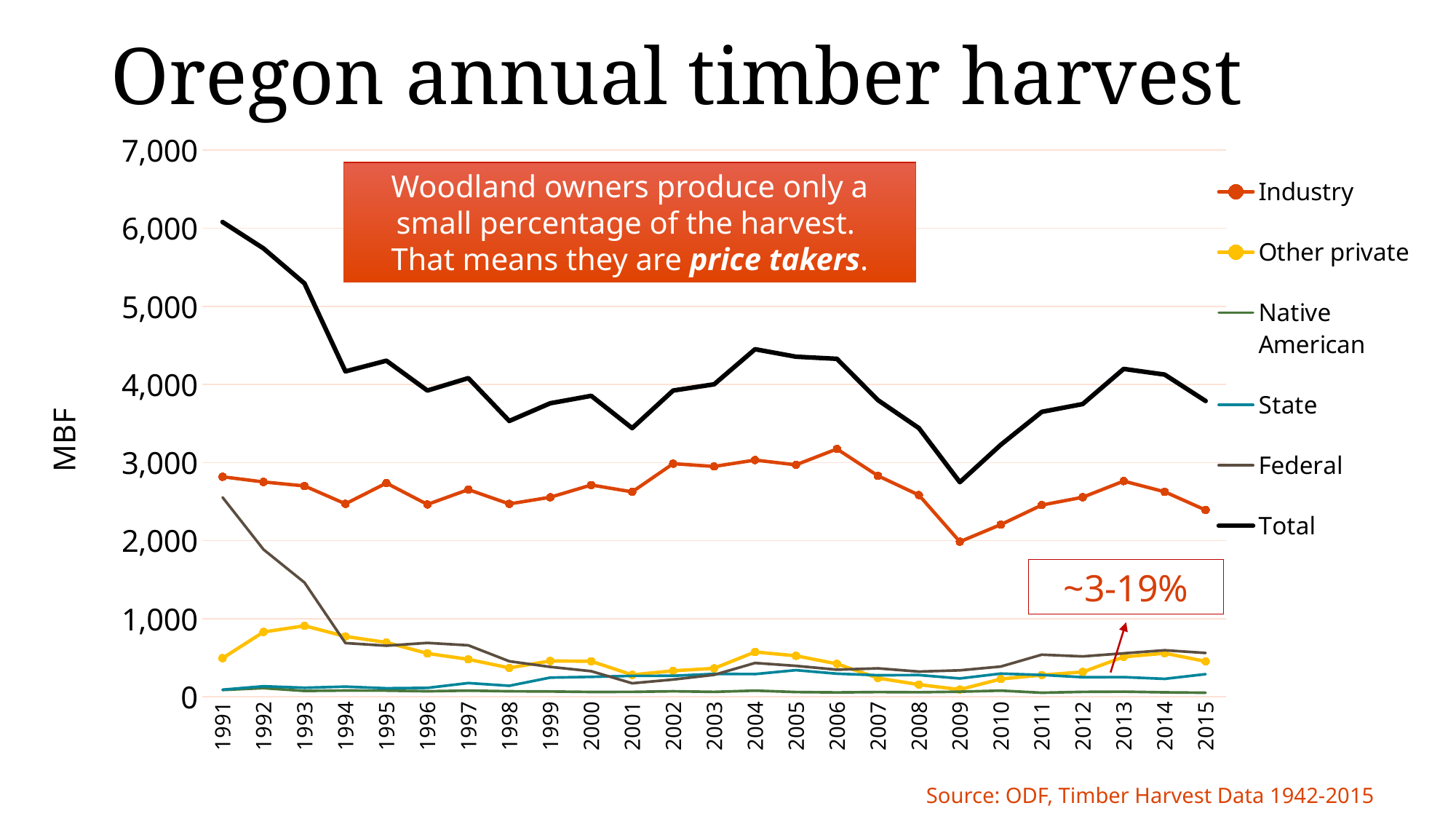
In which year is the Total harvest highest? 1991 Is the Industry value for 1991 greater or less than 2,000? greater Is the Total value for 2009 greater or less than 3,000? less Does the Federal series rise or fall from 1991 to 1994? fall How many years are plotted along the x axis? 25 In which year is the Total harvest lowest? 2009 Is the Total value for 1991 greater or less than 5,000? greater In 1991, which is larger: the Industry value or the Federal value? Industry In 1993, which is larger: the Federal value or the Other private value? Federal How many series does the legend list? 6 What is the label on the y axis? MBF What kind of chart is shown on the slide? line chart